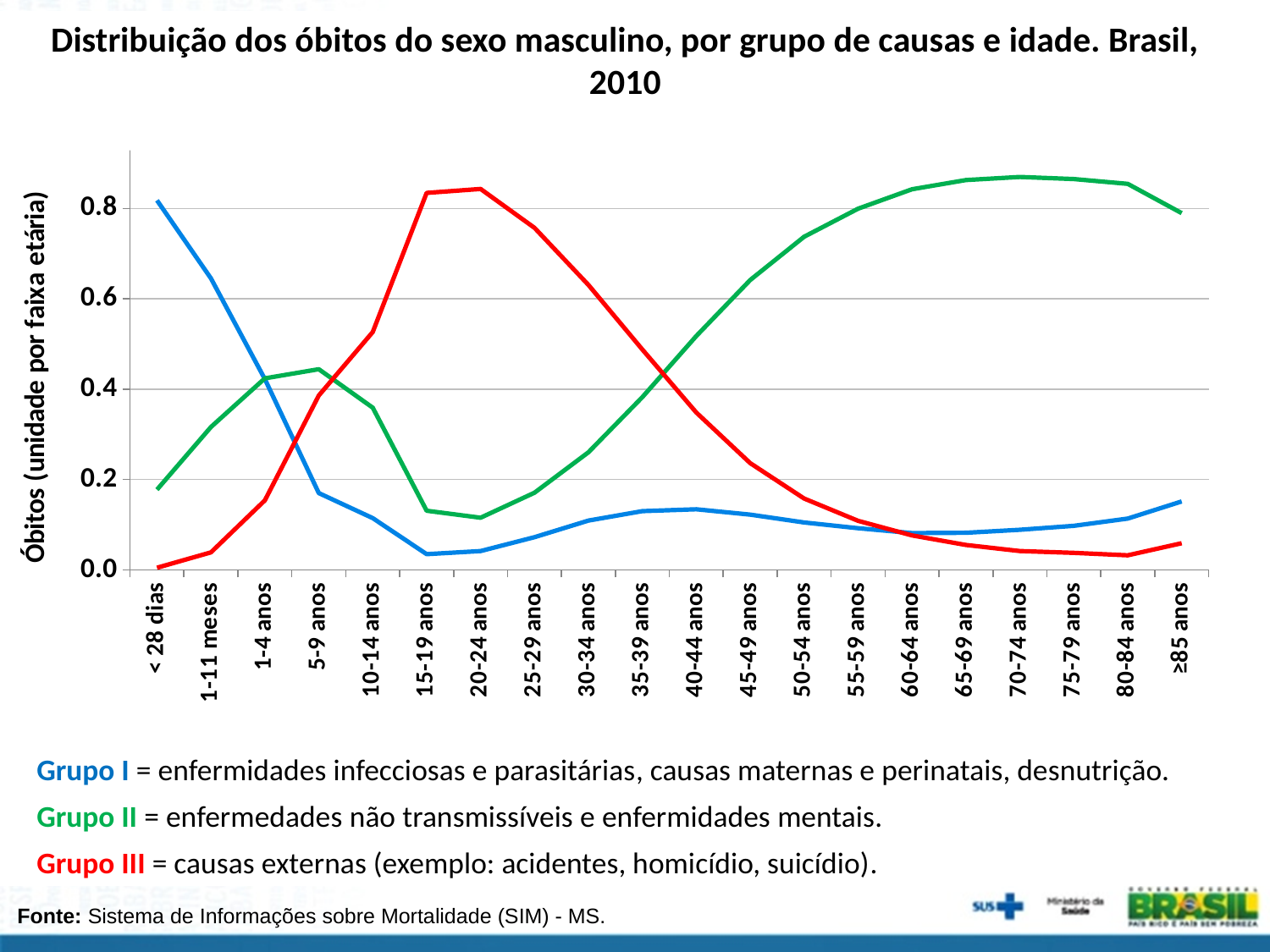
Is the value for Grupo II (green line) at 15-19 anos greater or less than 0.2? less At 20-24 anos, which is larger: the value for Grupo III (red line) or Grupo II (green line)? Grupo III Is the value for Grupo I (blue line) at < 28 dias greater or less than 0.6? greater What colour is the line for Grupo III on the chart? Red How many age groups are shown on the x axis of the chart? 20 Does the Grupo I (blue) line rise or fall from < 28 dias to 15-19 anos? fall Which age group has the lowest value for Grupo III (red line)? < 28 dias Is the value for Grupo II (green line) at 70-74 anos greater or less than 0.8? greater At 40-44 anos, which is larger: the value for Grupo II (green line) or Grupo III (red line)? Grupo II How many lines (series) are plotted on the chart? 3 Which age group has the highest value for Grupo I (blue line)? < 28 dias What kind of chart is shown on the slide? Line chart